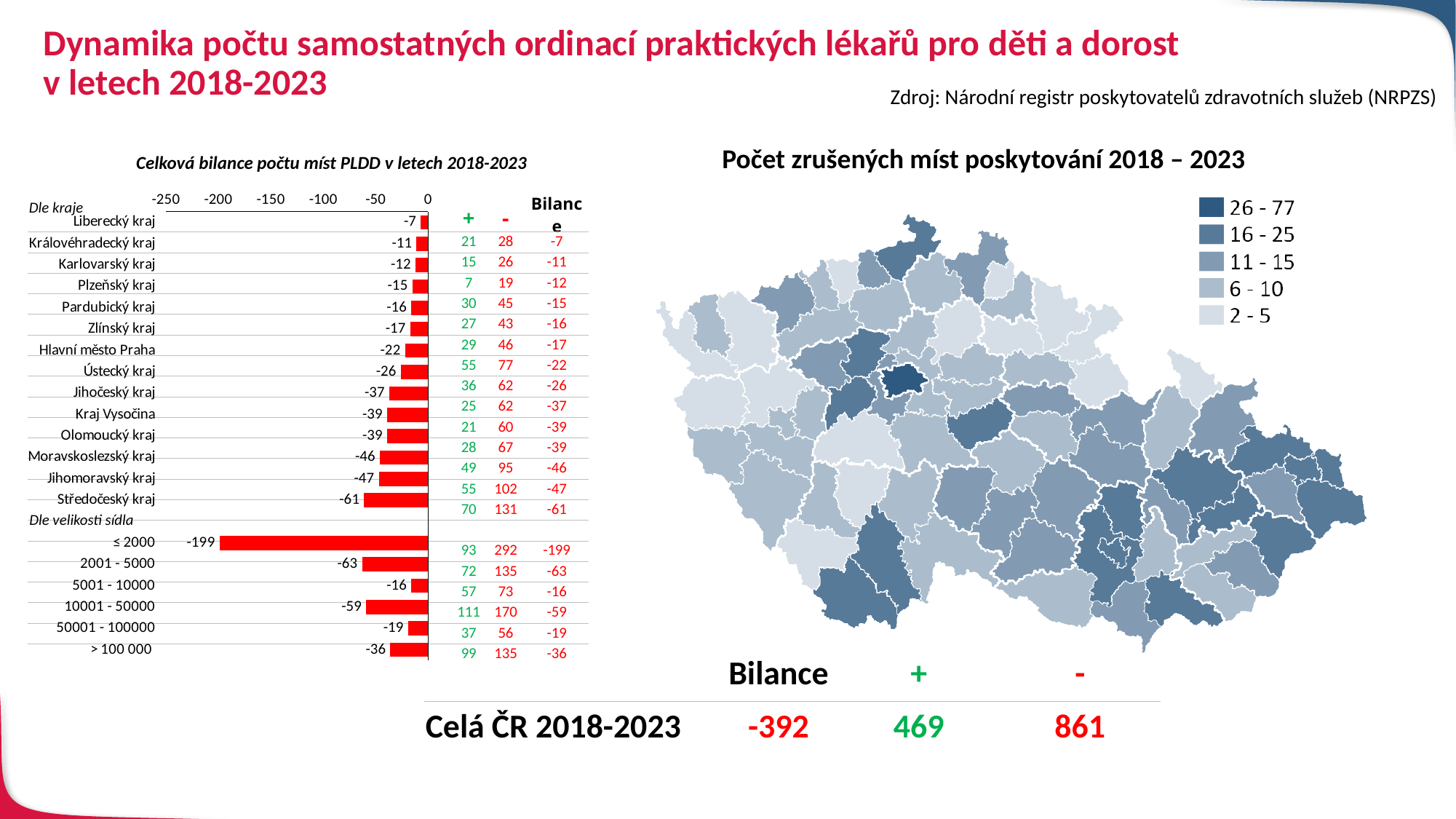
In the bar chart on the left, which region (kraj) has the value closest to zero? Liberecký kraj In the bar chart on the left, what is the difference between the values for ≤ 2000 (-199) and 2001 - 5000 (-63)? 136 In the bar chart on the left, what is the difference between the values for Středočeský kraj (-61) and Jihomoravský kraj (-47)? 14 In the bar chart 'Celková bilance počtu míst PLDD v letech 2018-2023', what is the value for Středočeský kraj? -61 In the bar chart on the left, what is the value for the settlement size category ≤ 2000? -199 How many bars (categories) are plotted in the bar chart on the left? 20 What kind of chart is shown on the left of the slide? bar chart In the bar chart on the left, is the value for ≤ 2000 greater or less than -150? less What is the leftmost (minimum) tick value on the horizontal axis of the bar chart on the left? -250 In the bar chart on the left, what is the value for Hlavní město Praha? -22 In the bar chart on the left, which has the larger decline, Jihočeský kraj or Ústecký kraj? Jihočeský kraj In the bar chart on the left, which category has the most negative (lowest) value? ≤ 2000